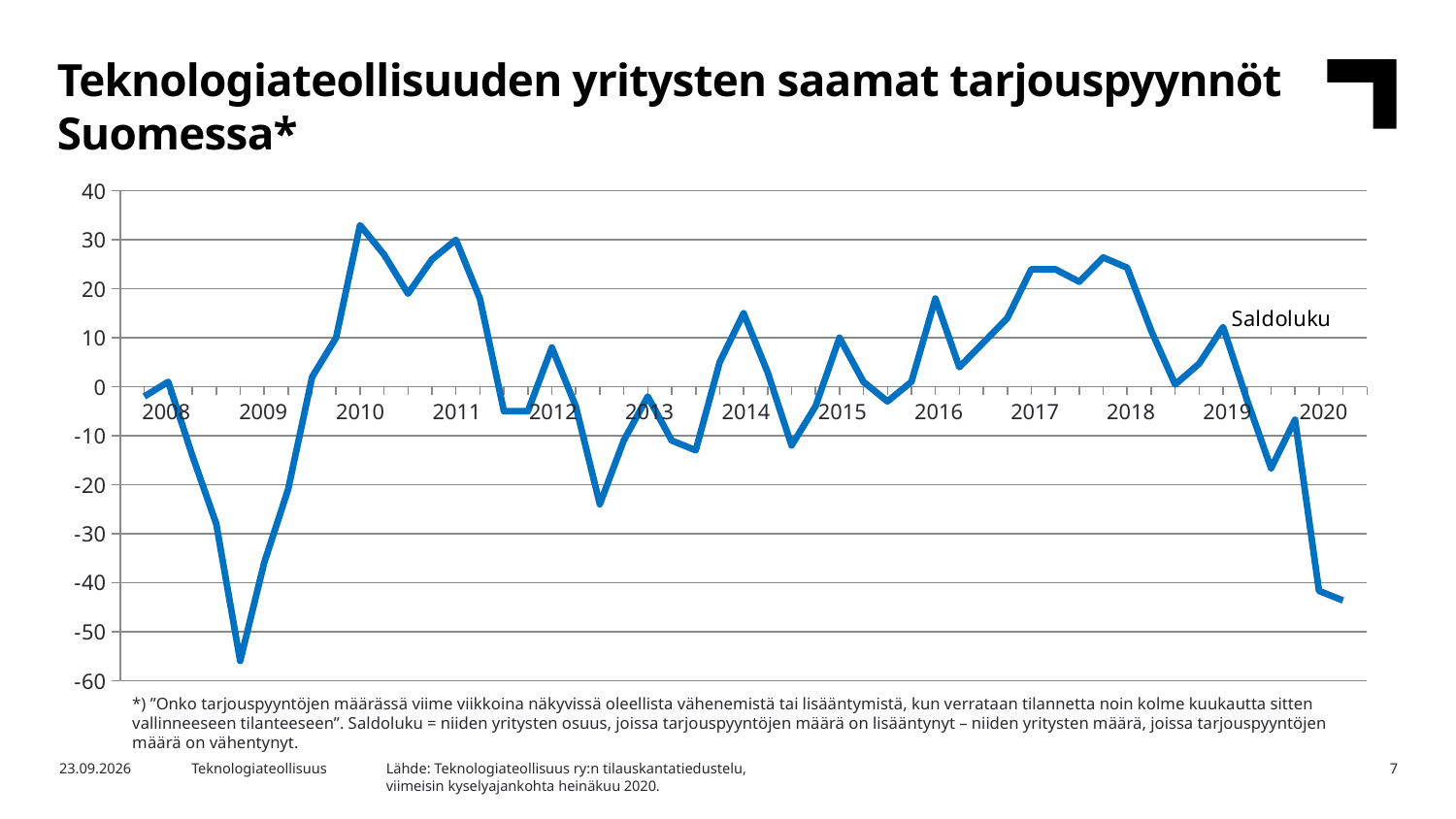
Which is higher, the peak of the line in 2010 or the peak in 2018? 2010 What is the name of the series plotted on the chart? Saldoluku What kind of chart is shown on the slide? line chart Does the line rise or fall between 2009 and 2010? rise How many year labels are shown on the x axis? 13 Does the line rise or fall between 2019 and 2020? fall Is the peak value of the line in 2018 greater or less than 20? greater Is the last value of the line in 2020 greater or less than -30? less Is the lowest value of the line, reached between 2008 and 2009, greater or less than -50? less How many series does the chart show? 1